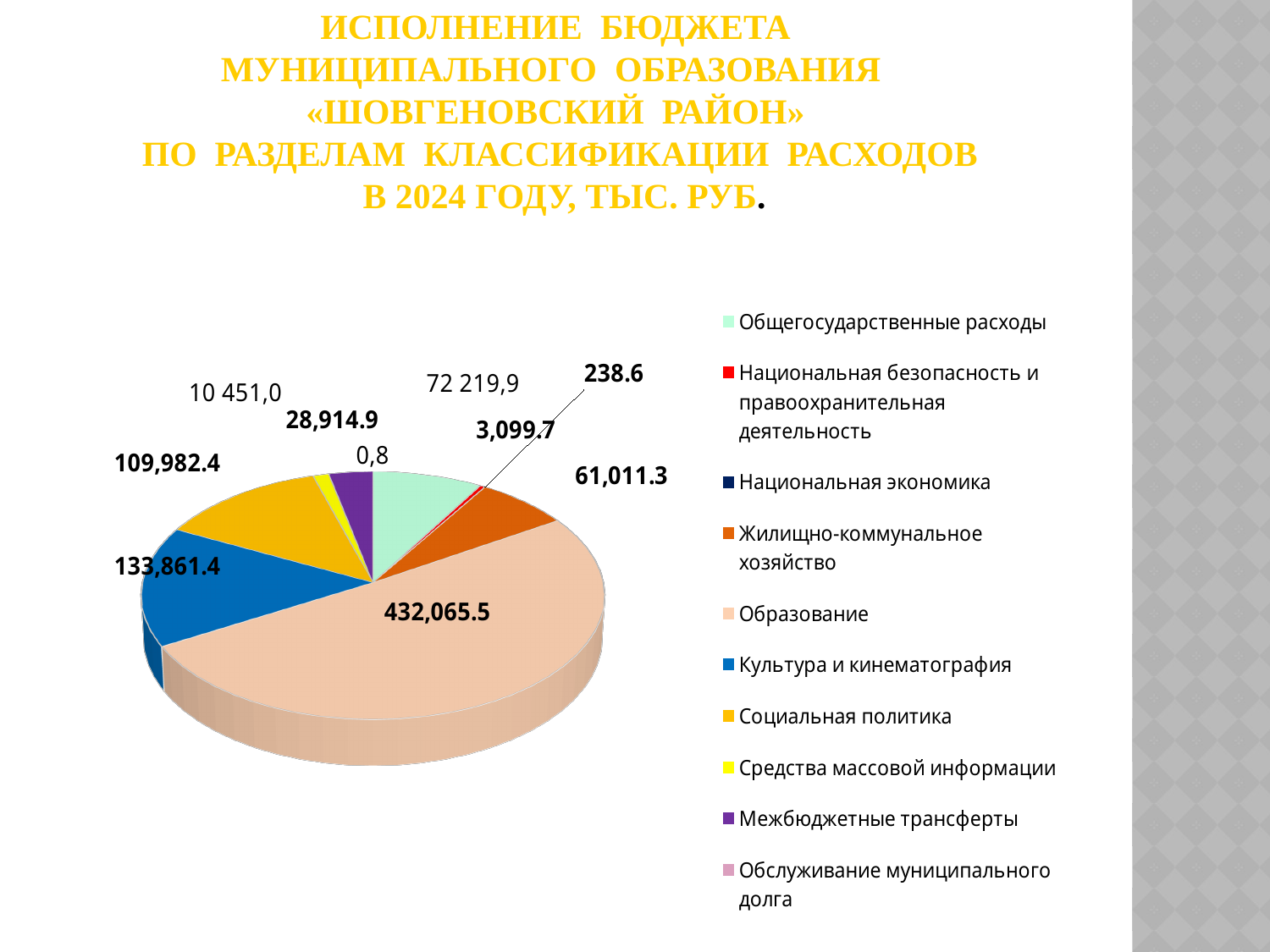
Which category has the largest slice of the pie chart? Образование What is the value shown for Социальная политика? 109,982.4 What is the value shown for Образование? 432,065.5 What is the value shown for Жилищно-коммунальное хозяйство? 61,011.3 What is the value shown for Культура и кинематография? 133,861.4 What is the value shown for Межбюджетные трансферты? 28,914.9 Which category has the smallest value in the pie chart? Обслуживание муниципального долга What is the difference between the values for Образование and Культура и кинематография? 298,204.1 In what units are the values in the chart expressed, according to the slide title? тыс. руб. Which is larger, the value for Культура и кинематография or the value for Социальная политика? Культура и кинематография How many categories does the legend of the pie chart list? 10 What kind of chart is shown on the slide? Pie chart